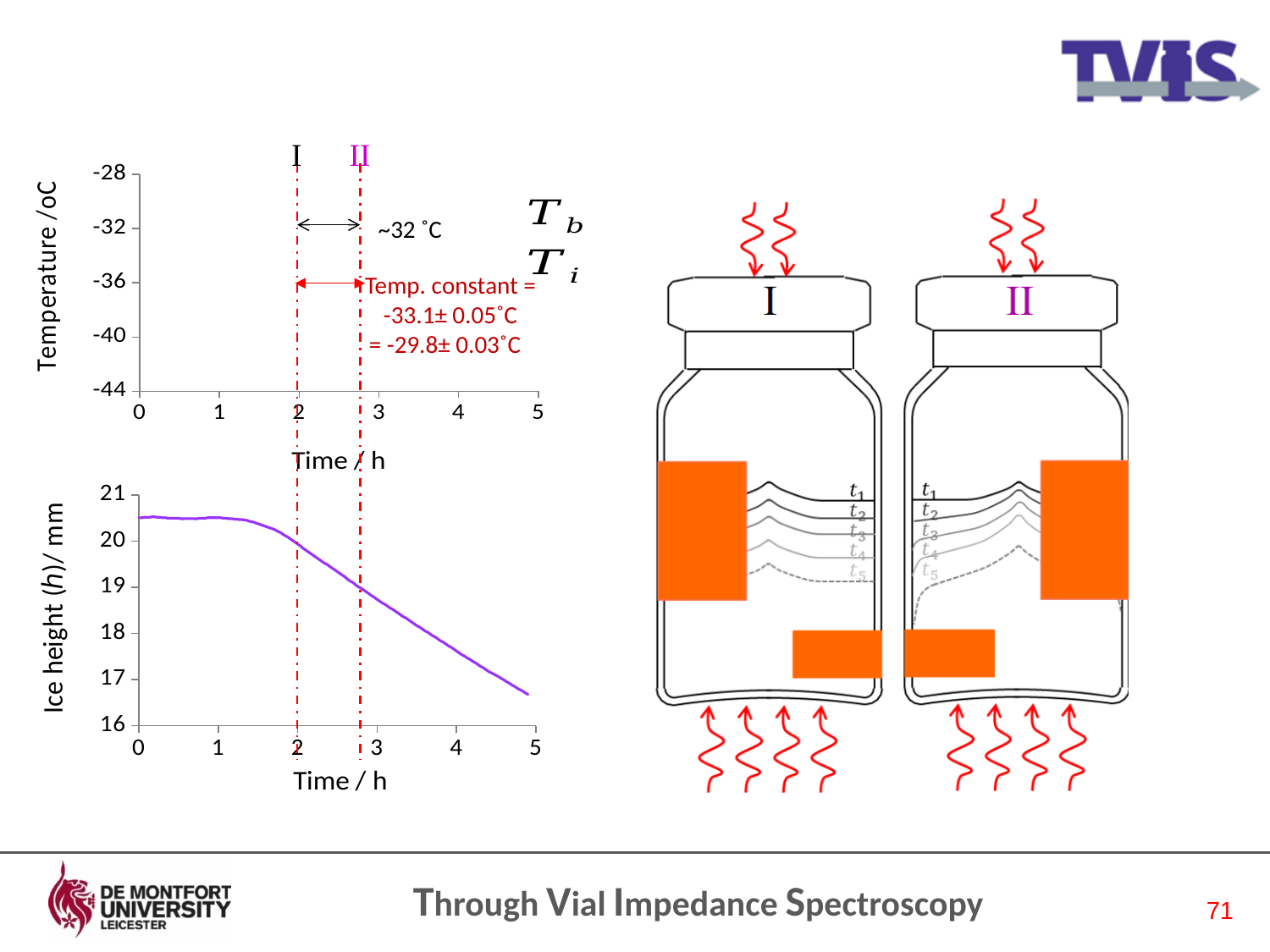
In the bottom chart (Ice height vs Time), is the ice height at time 2 h greater or less than 19 mm? greater In the bottom chart (Ice height vs Time), does the ice height rise or fall as time increases? fall In the bottom chart (Ice height vs Time), is the ice height at time 4 h greater or less than 19 mm? less In the bottom chart (Ice height vs Time), is the ice height lowest at the start or at the end of the time range? at the end What is the y-axis label of the bottom chart? Ice height (h)/ mm In the bottom chart (Ice height vs Time), which is larger: the ice height at 1 h or at 4 h? 1 h What is the y-axis label of the top chart? Temperature /oC In the bottom chart (Ice height vs Time), is the ice height at time 0 h greater or less than 20 mm? greater How many data series are plotted in the bottom chart (Ice height vs Time)? 1 What kind of chart is the bottom chart (Ice height vs Time)? line chart